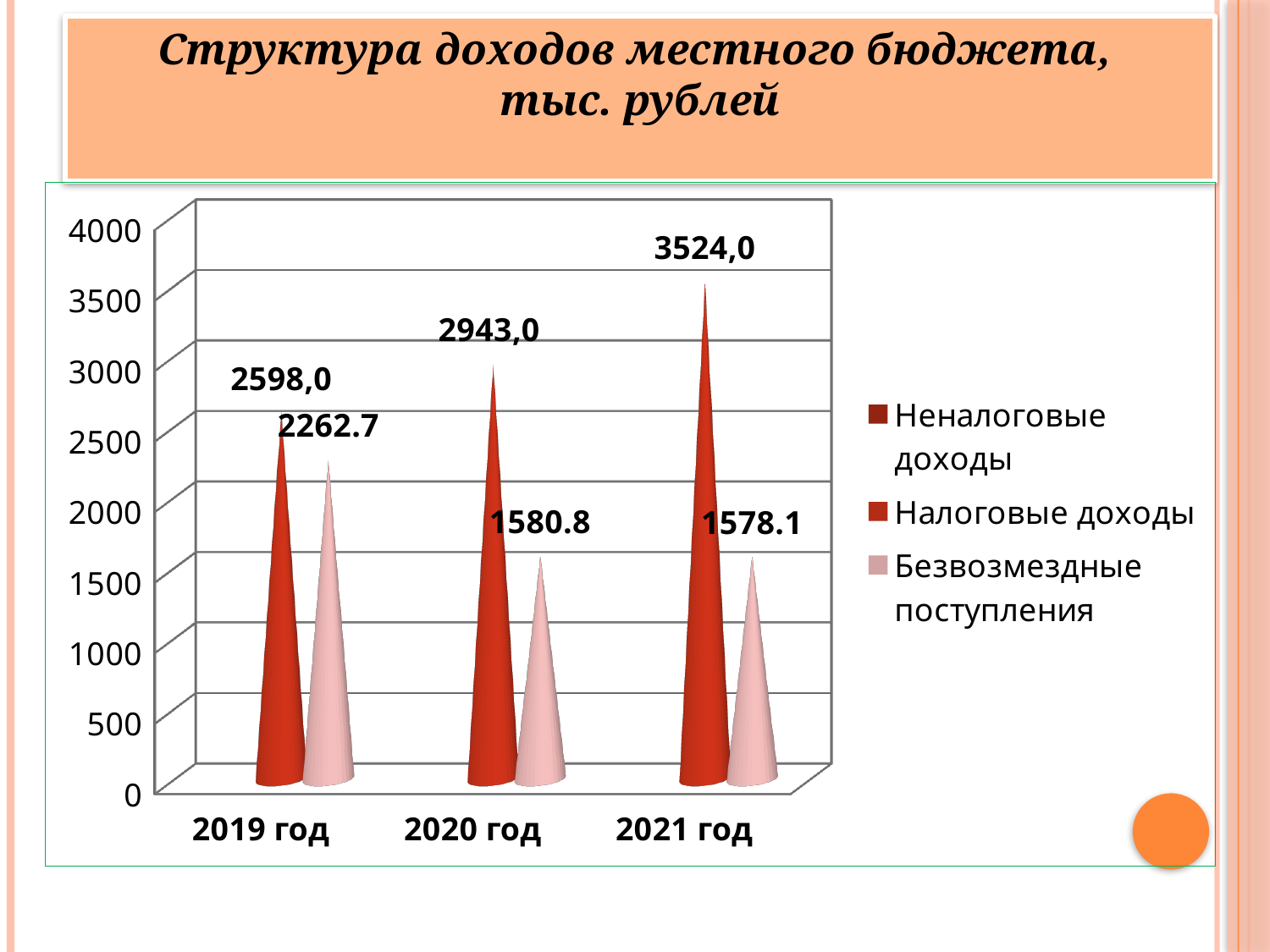
What is the value of Безвозмездные поступления for 2019 год? 2262.7 What is the value of Безвозмездные поступления for 2021 год? 1578.1 How many years are shown on the x axis? 3 Which year has the larger value for Безвозмездные поступления, 2019 год or 2020 год? 2019 год What is the difference between the red cone values for 2021 год (3524,0) and 2020 год (2943,0)? 581,0 What is the value labelled on the red cone for 2021 год? 3524,0 Do the red cone values rise or fall from 2019 год to 2021 год? rise How many series does the legend list? 3 What is the value of Безвозмездные поступления for 2020 год? 1580.8 What kind of chart is shown on the slide? bar chart What is the value labelled on the red cone for 2019 год? 2598,0 In which year is the red cone value the highest? 2021 год